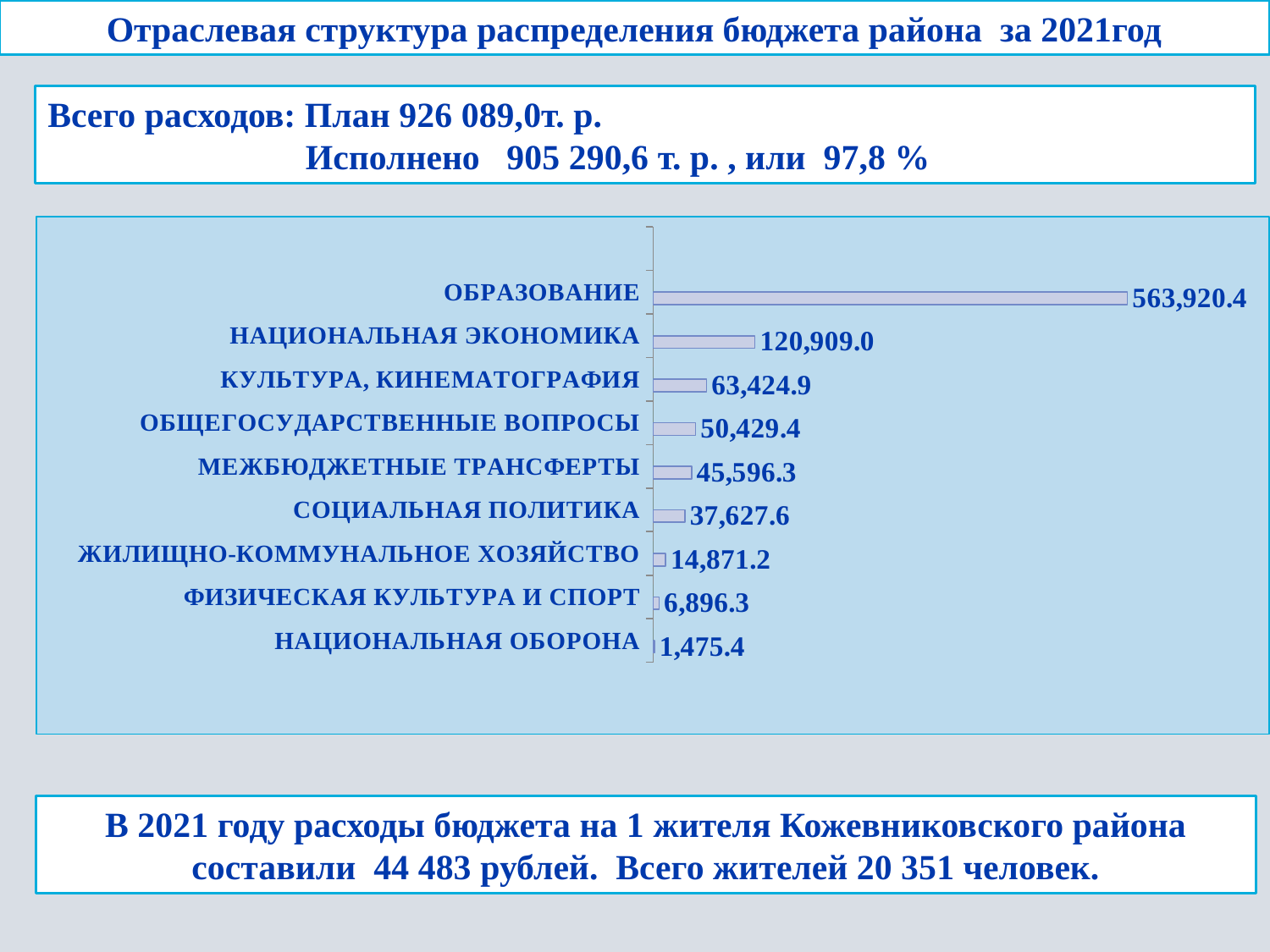
Which category has the highest value? ОБРАЗОВАНИЕ Which category has the lowest value? НАЦИОНАЛЬНАЯ ОБОРОНА What kind of chart is shown on the slide? bar chart What is the value for ЖИЛИЩНО-КОММУНАЛЬНОЕ ХОЗЯЙСТВО? 14,871.2 Which is larger: the value for ФИЗИЧЕСКАЯ КУЛЬТУРА И СПОРТ or the value for ЖИЛИЩНО-КОММУНАЛЬНОЕ ХОЗЯЙСТВО? ЖИЛИЩНО-КОММУНАЛЬНОЕ ХОЗЯЙСТВО What is the value for НАЦИОНАЛЬНАЯ ОБОРОНА? 1,475.4 Which is larger: the value for МЕЖБЮДЖЕТНЫЕ ТРАНСФЕРТЫ or the value for СОЦИАЛЬНАЯ ПОЛИТИКА? МЕЖБЮДЖЕТНЫЕ ТРАНСФЕРТЫ How many categories are shown in the chart? 9 What is the value for ОБРАЗОВАНИЕ? 563,920.4 What is the difference between the values for ОБРАЗОВАНИЕ and НАЦИОНАЛЬНАЯ ЭКОНОМИКА? 443,011.4 What is the difference between the values for КУЛЬТУРА, КИНЕМАТОГРАФИЯ and ОБЩЕГОСУДАРСТВЕННЫЕ ВОПРОСЫ? 12,995.5 What is the value for НАЦИОНАЛЬНАЯ ЭКОНОМИКА? 120,909.0